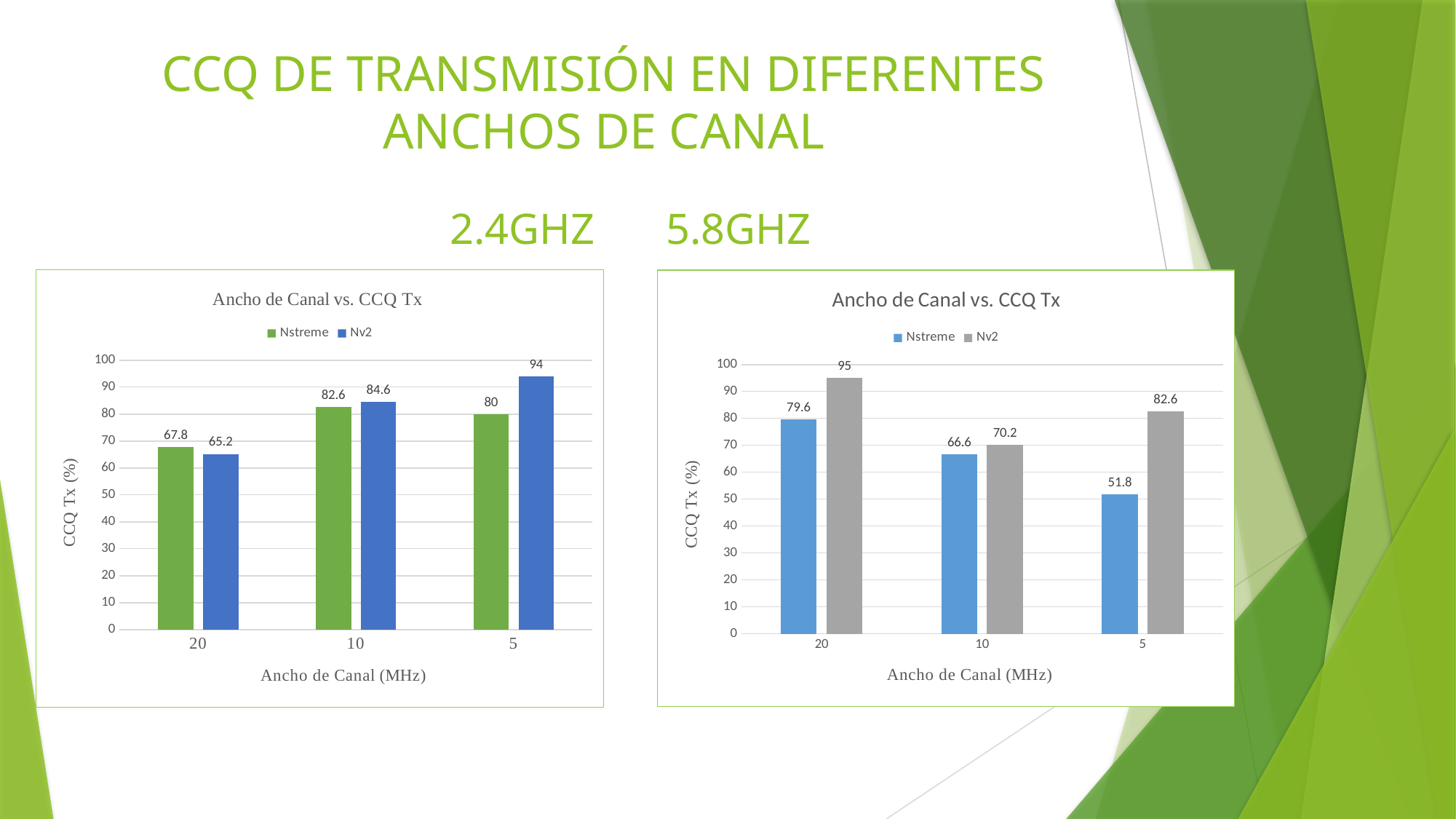
What kind of chart is the 2.4GHZ chart (left)? Bar chart In the 5.8GHZ chart (right), is the Nstreme value at 5 MHz greater or less than 60? less In the 2.4GHZ chart (left), what is the CCQ Tx value for Nstreme at 20 MHz channel width? 67.8 How many series does the legend of the 5.8GHZ chart (right) list? 2 What is the y-axis label of the 2.4GHZ chart (left)? CCQ Tx (%) In the 5.8GHZ chart (right), what is the difference between the Nv2 and Nstreme values at 20 MHz? 15.4 In the 2.4GHZ chart (left), which is larger at 20 MHz: Nstreme or Nv2? Nstreme In the 2.4GHZ chart (left), which channel width has the highest Nv2 value? 5 How many channel width categories are shown on the x axis of the 2.4GHZ chart (left)? 3 In the 5.8GHZ chart (right), what is the CCQ Tx value for Nv2 at 5 MHz channel width? 82.6 In the 5.8GHZ chart (right), which channel width has the lowest Nstreme value? 5 In the 5.8GHZ chart (right), do the Nstreme values rise or fall from 20 MHz to 5 MHz along the x axis? Fall